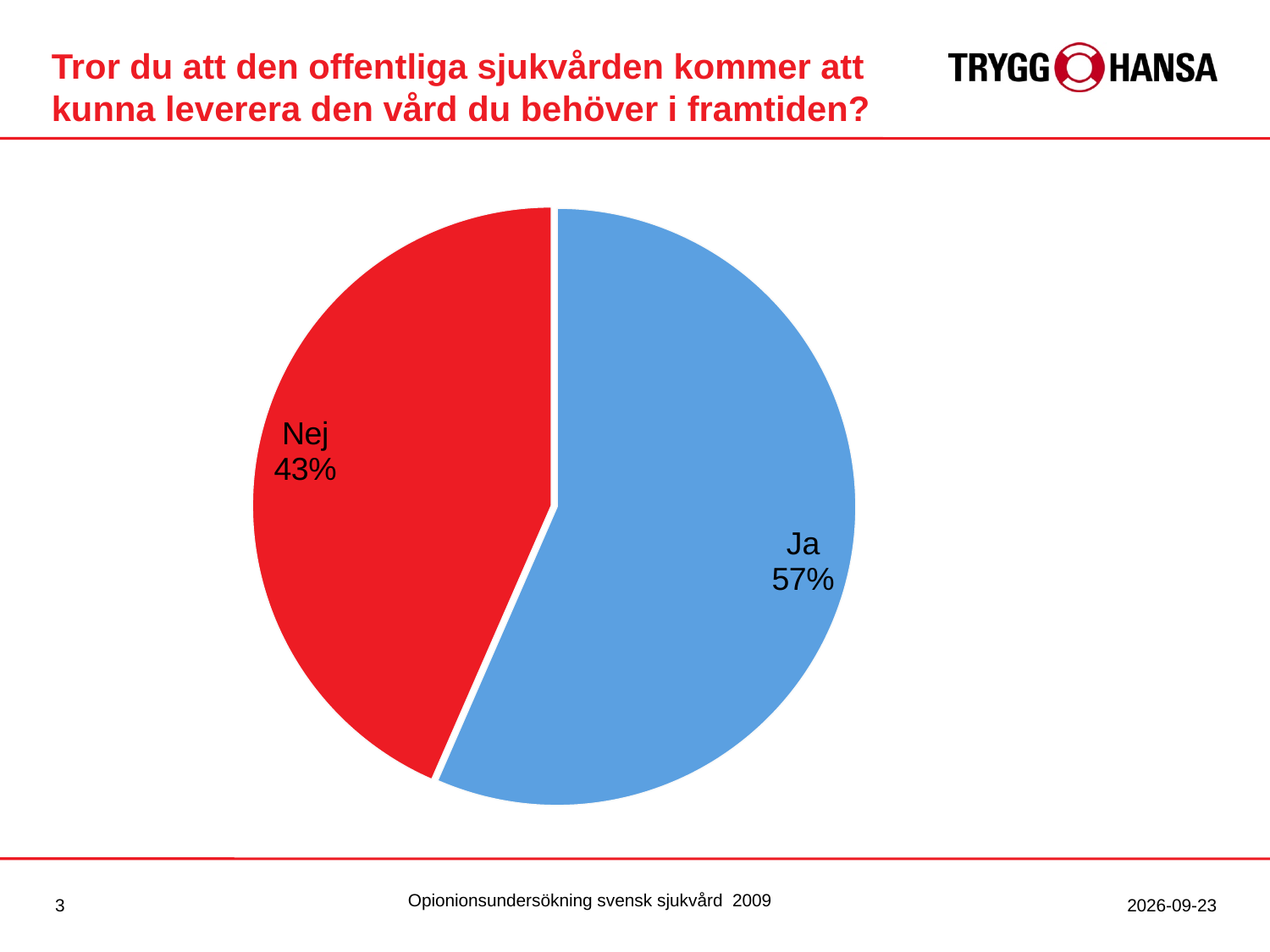
Which slice of the pie is the smallest? Nej What is the total of the two slices shown in the pie chart? 100% Which slice of the pie is the largest? Ja What is the difference in percentage points between the "Ja" and "Nej" slices? 14 What kind of chart is shown on the slide? pie chart What colour is the "Ja" slice of the pie? blue What share of the pie is labelled "Ja"? 57% What colour is the "Nej" slice of the pie? red What share of the pie is labelled "Nej"? 43% Which is larger, the "Ja" slice or the "Nej" slice? Ja How many slices does the pie chart have? 2 Is the share for "Nej" greater or less than 50%? less